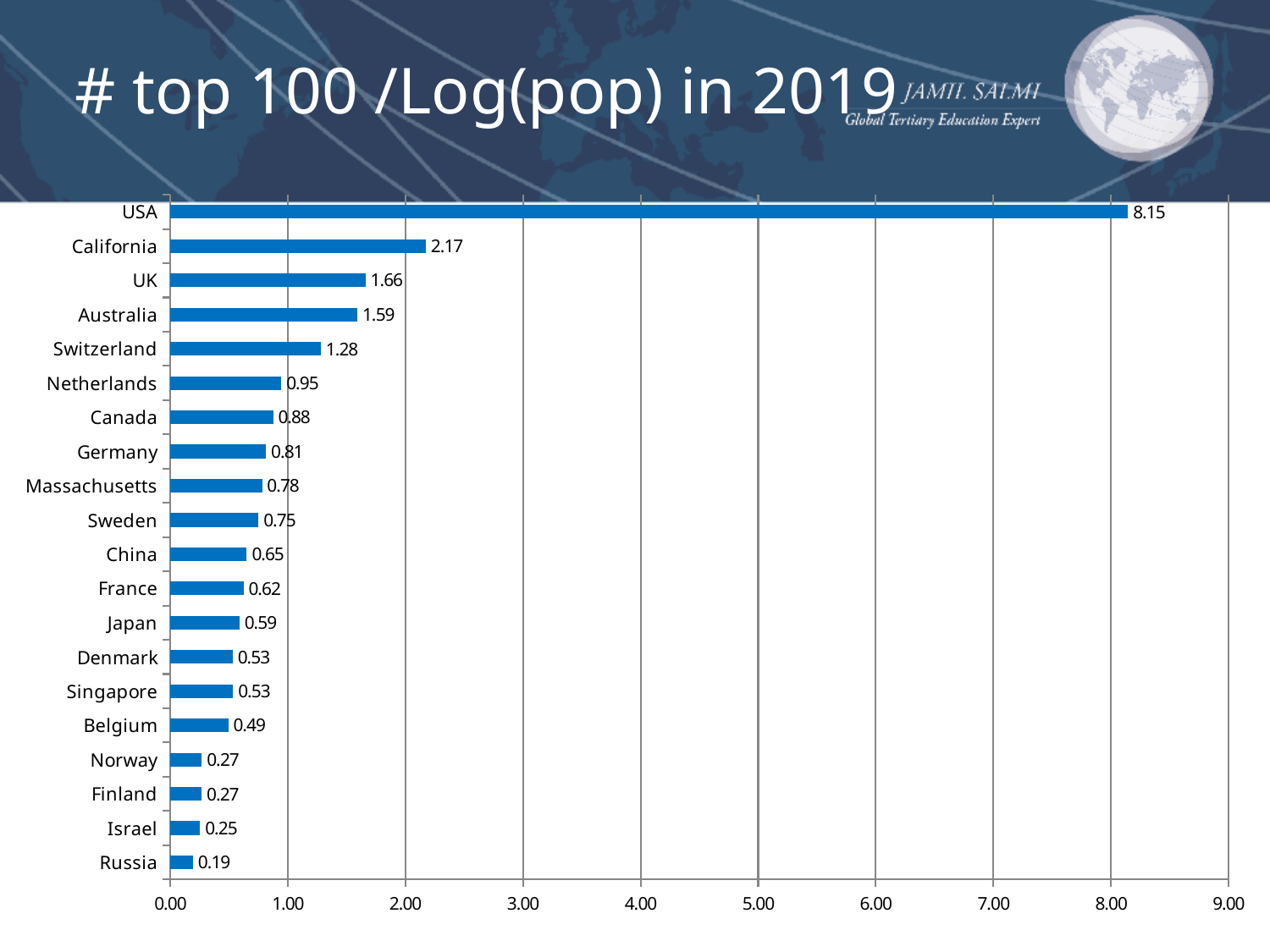
What is the value for Switzerland? 1.28 Is the value for the Netherlands greater or less than 1.00? less What is the difference between the values for Australia and Belgium? 1.10 What is the title of the slide? # top 100 /Log(pop) in 2019 How many categories are shown in the chart? 20 What kind of chart is shown on the slide? bar chart Which is larger, the value for Germany or the value for Sweden? Germany What is the value for the USA? 8.15 What is the value for Japan? 0.59 Which category has the lowest value? Russia Which category has the highest value? USA What is the difference between the values for California and the UK? 0.51